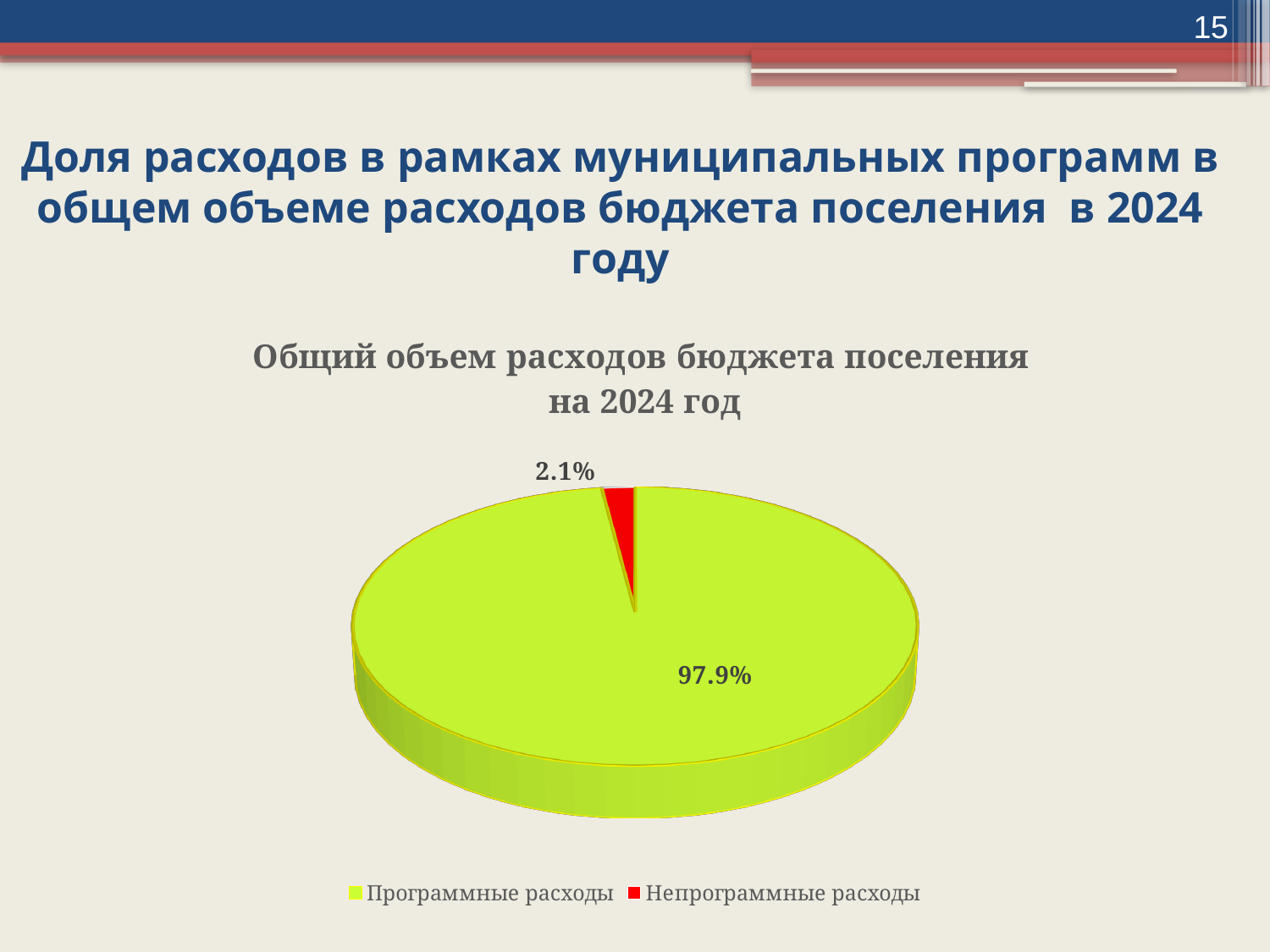
How many entries does the legend list? 2 Which category has the smallest slice of the pie? Непрограммные расходы What kind of chart is shown on the slide? Pie chart What share of the pie is Программные расходы? 97.9% Which category has the largest slice of the pie? Программные расходы What share of the pie is Непрограммные расходы? 2.1% Which is larger, the share of Программные расходы or the share of Непрограммные расходы? Программные расходы What is the chart's title? Общий объем расходов бюджета поселения на 2024 год What colour is the slice for Непрограммные расходы? Red What is the difference in percentage points between Программные расходы and Непрограммные расходы? 95.8 How many slices does the pie chart have? 2